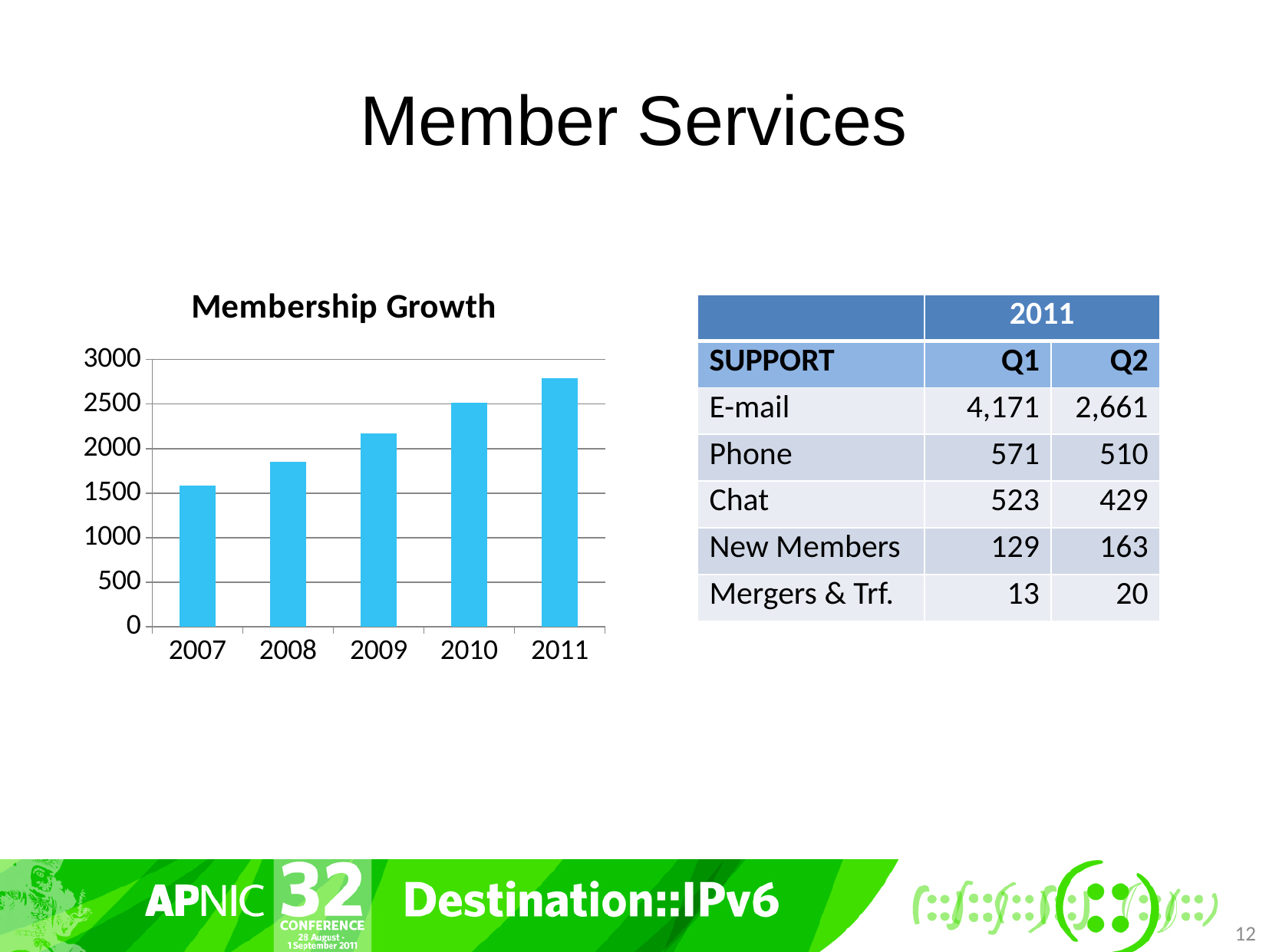
Is the value for 2008 in the Membership Growth chart greater or less than 2000? less Is the value for 2011 in the Membership Growth chart greater or less than 3000? less What is the title of the chart on the slide? Membership Growth How many years are shown on the x axis of the Membership Growth chart? 5 Is the value for 2009 in the Membership Growth chart greater or less than 2000? greater Which year has the lowest bar in the Membership Growth chart? 2007 Do the values in the Membership Growth chart rise or fall from 2007 to 2011? rise What kind of chart is the Membership Growth chart? bar chart Which year has the highest bar in the Membership Growth chart? 2011 In the Membership Growth chart, which is larger, the value for 2009 or the value for 2010? 2010